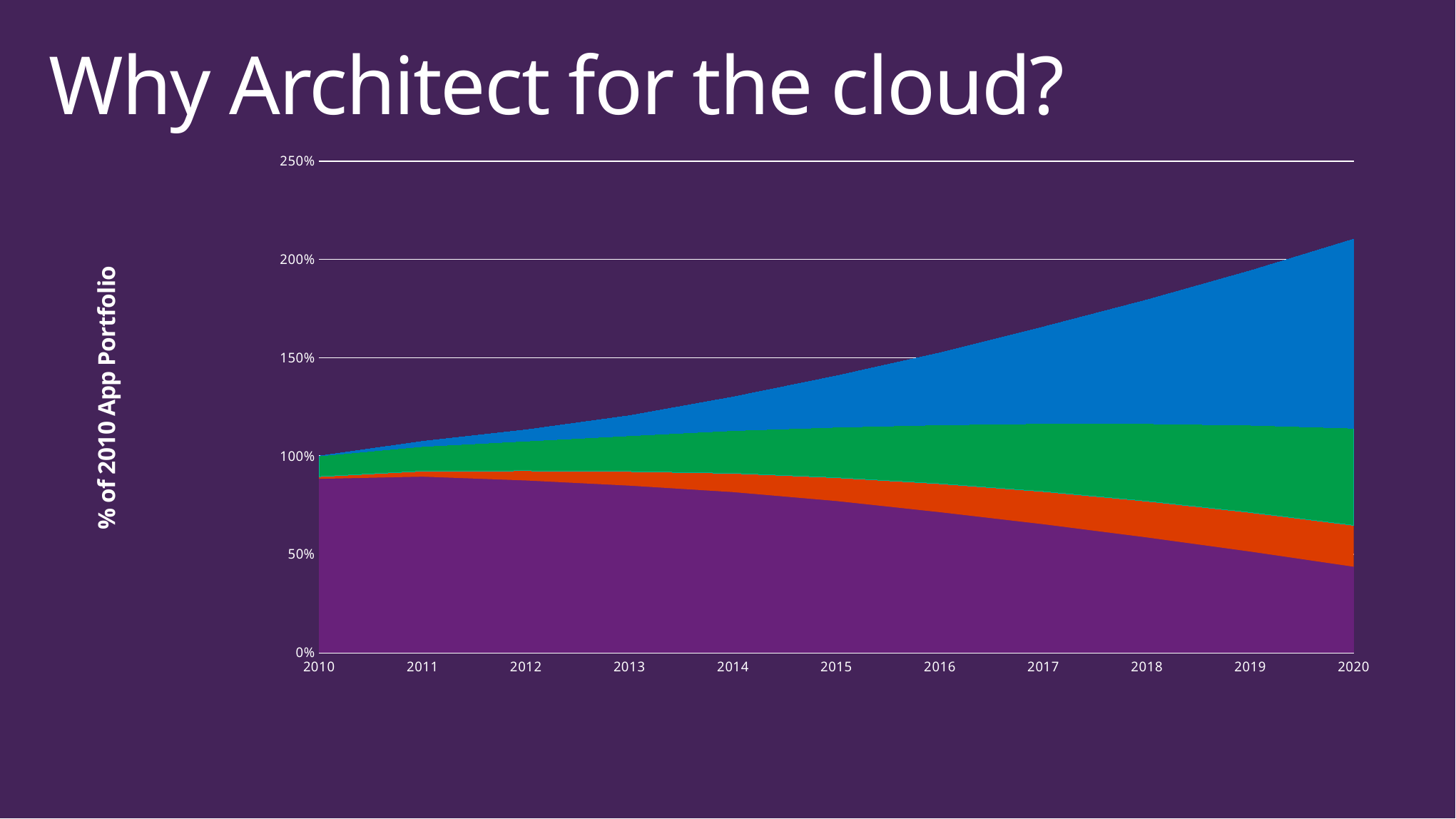
What is the highest value labelled on the vertical axis of the chart? 250% Does the total height of the stacked areas rise or fall from 2010 to 2020? Rise How many years are labelled along the x axis of the chart? 11 Is the value of the purple (bottom) area in 2010 greater or less than 100%? less Is the value of the purple (bottom) area in 2020 greater or less than 50%? less What is the title of the vertical axis of the chart? % of 2010 App Portfolio Is the total stacked value in 2020 greater or less than 200%? greater Which year is the first labelled on the x axis of the chart? 2010 Does the purple (bottom) area rise or fall from 2011 to 2020? Fall What kind of chart is shown on the slide? Stacked area chart